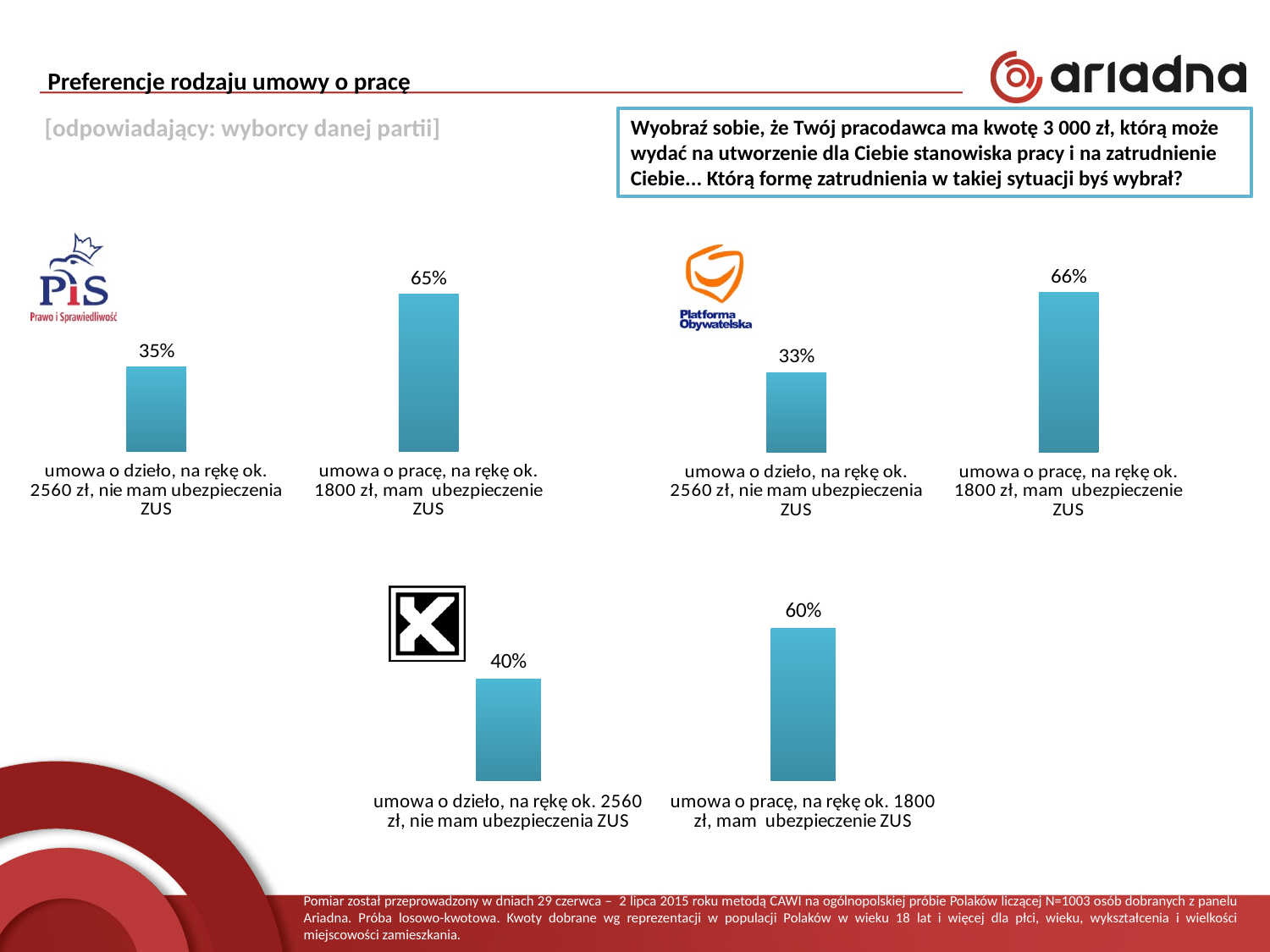
In the PiS chart (top left), what percentage chose 'umowa o pracę, na rękę ok. 1800 zł, mam ubezpieczenie ZUS'? 65% In the bottom chart, what is the difference between the 'umowa o pracę' value and the 'umowa o dzieło' value? 20 percentage points In the Platforma Obywatelska chart (top right), what percentage chose 'umowa o pracę, na rękę ok. 1800 zł, mam ubezpieczenie ZUS'? 66% In the bottom chart, what percentage chose 'umowa o pracę, na rękę ok. 1800 zł, mam ubezpieczenie ZUS'? 60% In the Platforma Obywatelska chart (top right), which option has the lower value? umowa o dzieło, na rękę ok. 2560 zł, nie mam ubezpieczenia ZUS In the PiS chart (top left), what is the difference between the 'umowa o pracę' value and the 'umowa o dzieło' value? 30 percentage points How many bars does the Platforma Obywatelska chart (top right) contain? 2 In the Platforma Obywatelska chart (top right), what percentage chose 'umowa o dzieło, na rękę ok. 2560 zł, nie mam ubezpieczenia ZUS'? 33% In the bottom chart, what percentage chose 'umowa o dzieło, na rękę ok. 2560 zł, nie mam ubezpieczenia ZUS'? 40% In the PiS chart (top left), what percentage chose 'umowa o dzieło, na rękę ok. 2560 zł, nie mam ubezpieczenia ZUS'? 35% In the PiS chart (top left), which option has the higher value? umowa o pracę, na rękę ok. 1800 zł, mam ubezpieczenie ZUS What type of chart is used on this slide? Bar chart